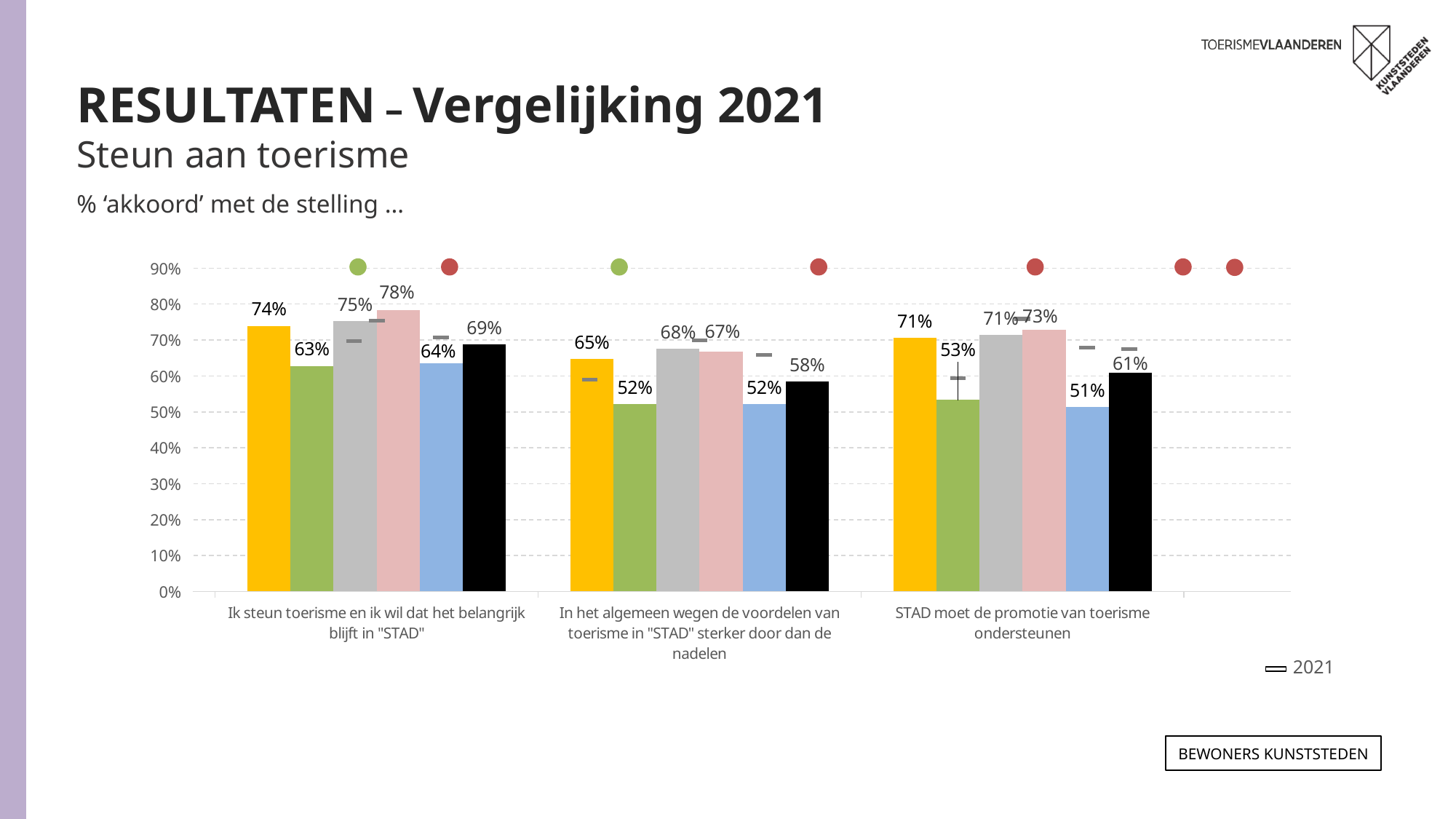
What year does the dash marker in the legend represent? 2021 Which bar has the highest value for the statement "Ik steun toerisme en ik wil dat het belangrijk blijft in "STAD""? The pink bar (78%) What is the value of the blue bar for the statement "STAD moet de promotie van toerisme ondersteunen"? 51% Is the value of the green bar for the statement "STAD moet de promotie van toerisme ondersteunen" greater or less than 60%? less How many bars are shown for each statement in the chart? 6 What is the difference between the pink bar (78%) and the green bar (63%) for the statement "Ik steun toerisme en ik wil dat het belangrijk blijft in "STAD""? 15 percentage points For the statement "In het algemeen wegen de voordelen van toerisme in "STAD" sterker door dan de nadelen", which is larger: the yellow bar or the grey bar? The grey bar (68%) What is the value of the yellow bar for the statement "Ik steun toerisme en ik wil dat het belangrijk blijft in "STAD""? 74% What is the lowest value shown for the statement "STAD moet de promotie van toerisme ondersteunen"? 51% What type of chart is shown on the slide? Bar chart What is the value of the black bar for the statement "In het algemeen wegen de voordelen van toerisme in "STAD" sterker door dan de nadelen"? 58% How many statements (categories) are shown on the x axis of the chart? 3